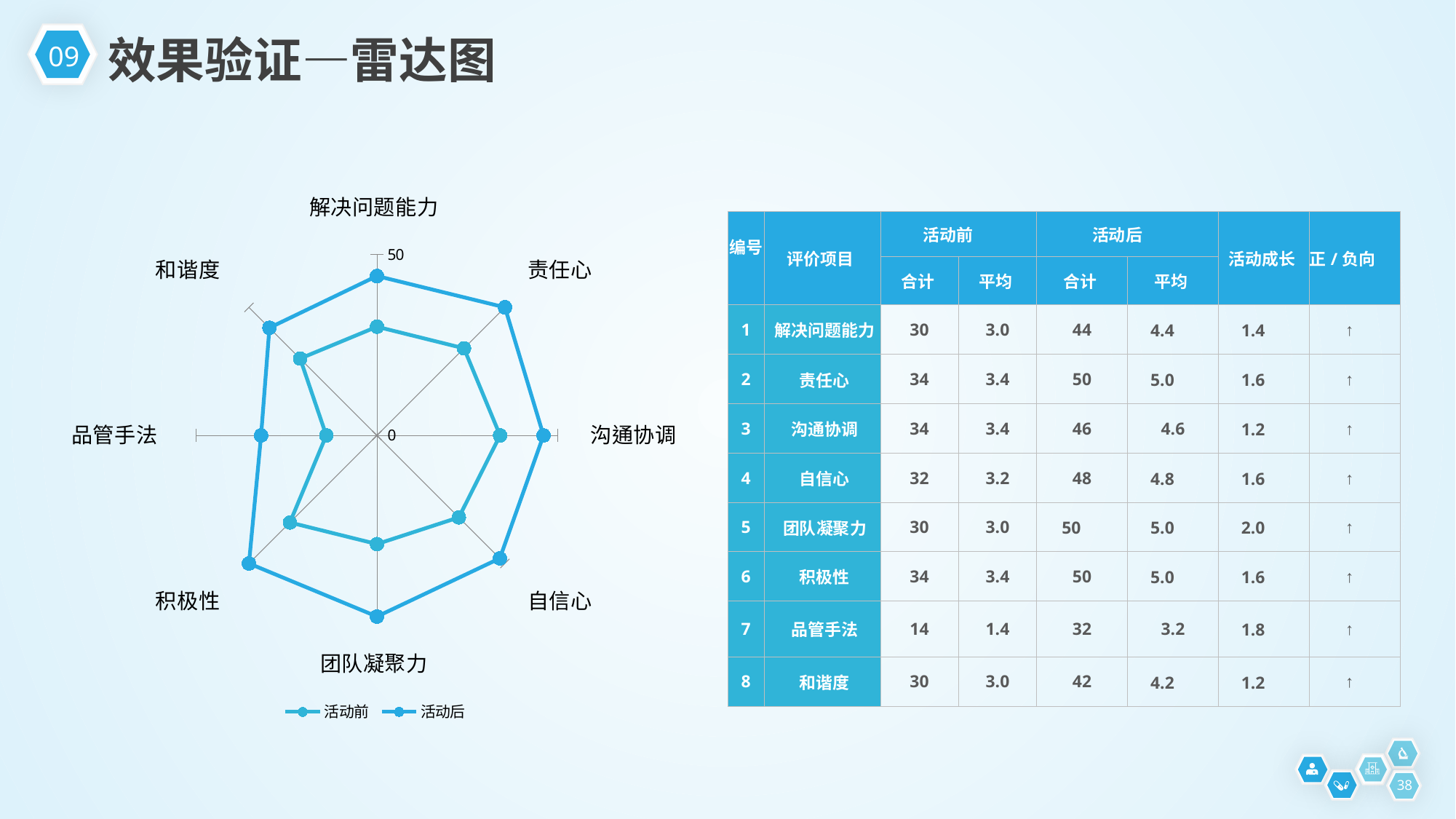
What kind of chart is shown on the left of the slide? radar chart In the radar chart, which category has the lowest value for the 活动前 series? 品管手法 According to the table on the slide, what is the 活动前 合计 value for 品管手法 plotted in the radar chart? 14 In the radar chart, which is larger for the 活动前 series: 品管手法 or 和谐度? 和谐度 What are the two series named in the radar chart's legend? 活动前 and 活动后 In the radar chart, which category has the lowest value for the 活动后 series? 品管手法 How many categories (axes) does the radar chart have? 8 How many series does the radar chart's legend list? 2 What is the maximum value shown on the radar chart's axis? 50 In the radar chart, is the 活动后 value for 团队凝聚力 larger or smaller than the 活动前 value for 团队凝聚力? larger Is the 活动前 value for 品管手法 in the radar chart greater or less than 50? less According to the table on the slide, what is the 活动后 合计 value for 团队凝聚力 plotted in the radar chart? 50